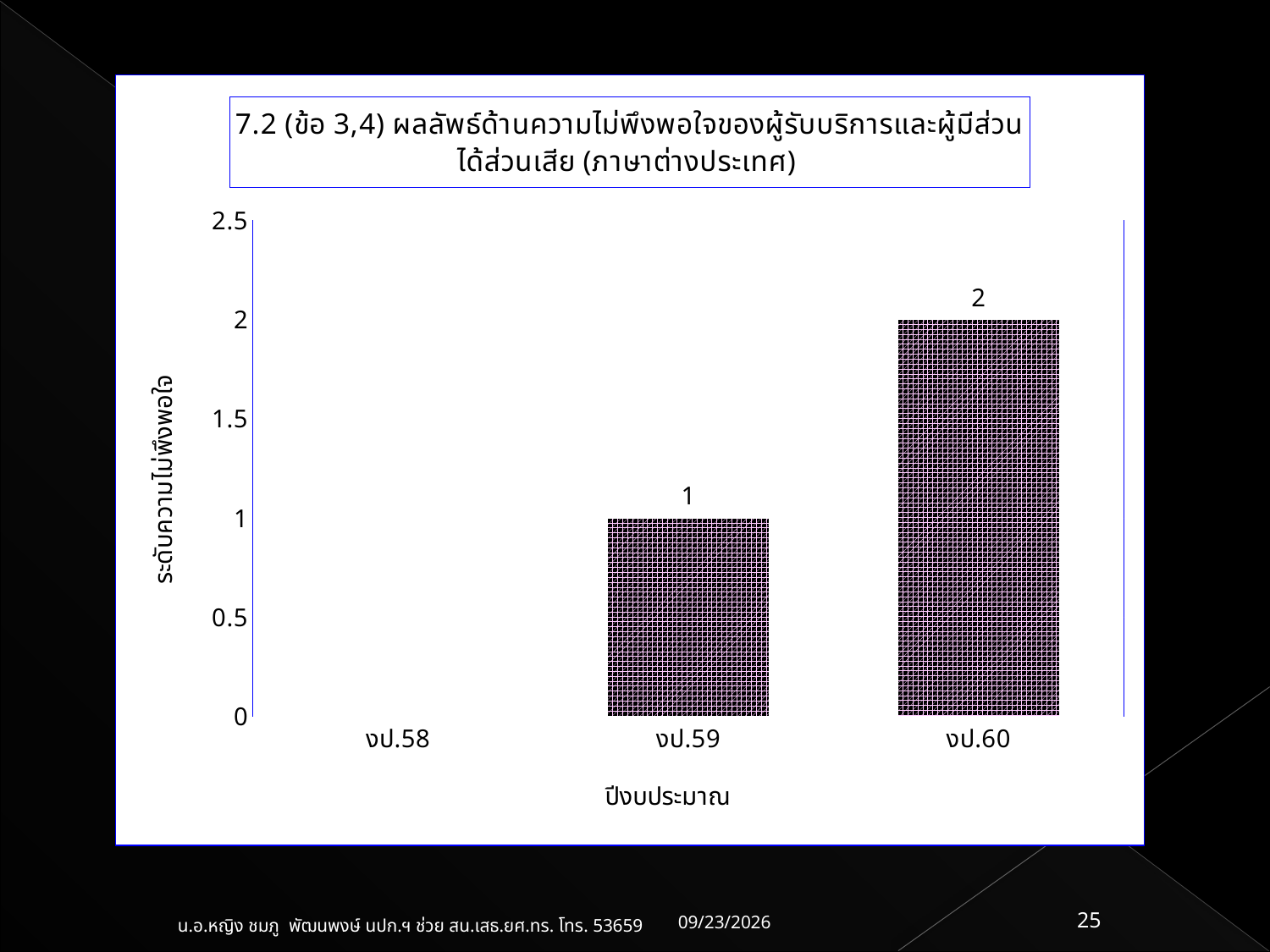
What kind of chart is shown on the slide? bar chart Do the values rise or fall from งป.59 to งป.60? rise What is the value for งป.59? 1 Is the value for งป.59 greater or less than 1.5? less Which is larger, the value for งป.59 or the value for งป.60? งป.60 Is the value for งป.60 greater or less than 1.5? greater What is the label of the x axis? ปีงบประมาณ What is the value for งป.60? 2 How many categories are shown on the x axis? 3 What is the label of the y axis? ระดับความไม่พึงพอใจ Which category has the highest value? งป.60 What is the difference between the values for งป.60 and งป.59? 1